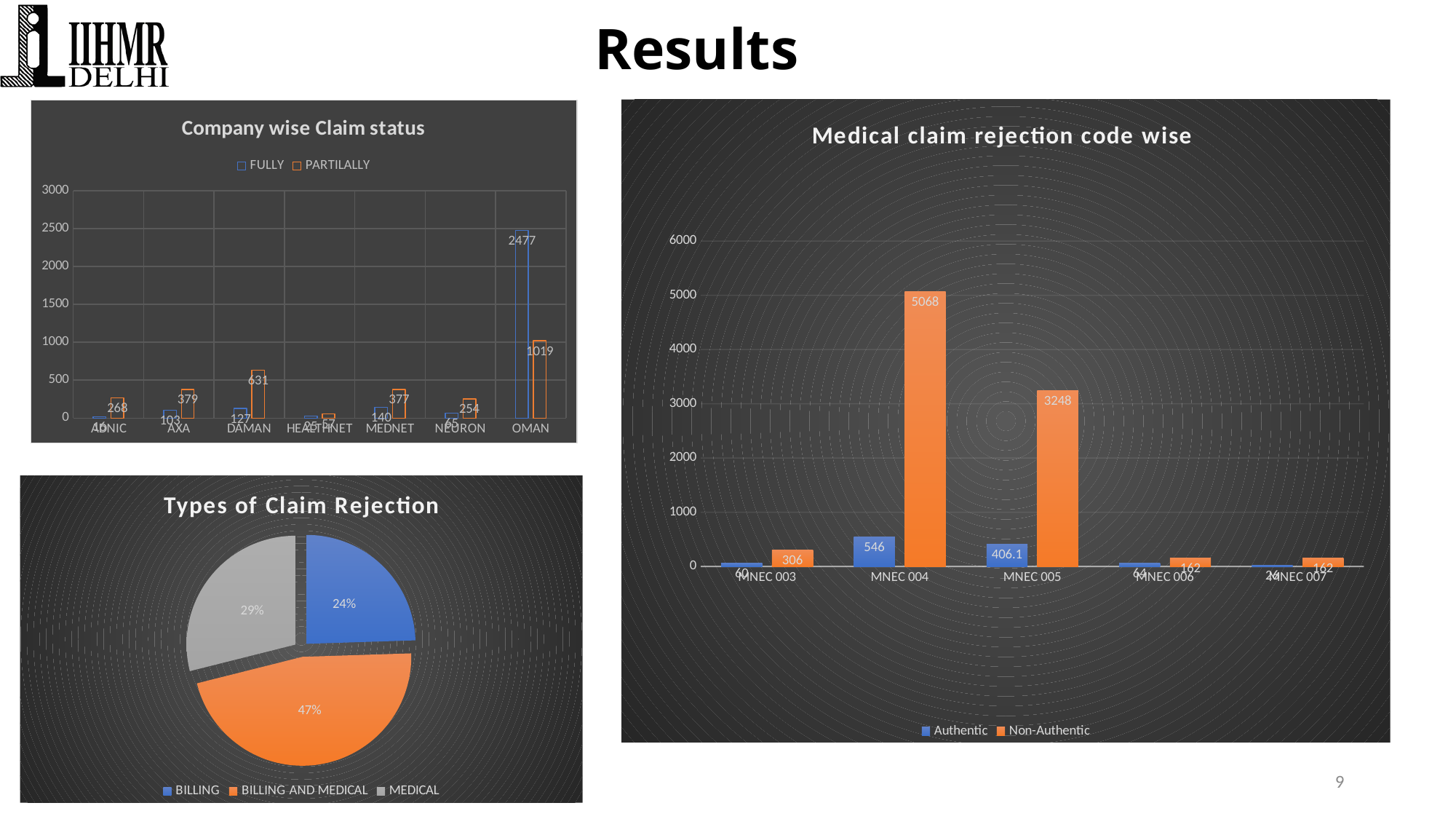
In the 'Company wise Claim status' chart, which company has the highest PARTIALLY value? OMAN In the 'Types of Claim Rejection' pie chart, what share does BILLING AND MEDICAL have? 47% In the 'Company wise Claim status' chart, what is the FULLY value for OMAN? 2477 In the 'Medical claim rejection code wise' chart, which is larger: the Non-Authentic value for MNEC 004 or for MNEC 005? MNEC 004 In the 'Medical claim rejection code wise' chart, what is the Authentic value for MNEC 005? 406.1 In the 'Medical claim rejection code wise' chart, what is the Non-Authentic value for MNEC 004? 5068 In the 'Types of Claim Rejection' pie chart, which category has the smallest slice? BILLING In the 'Company wise Claim status' chart, how many companies are shown on the x axis? 7 In the 'Company wise Claim status' chart, what is the difference between the FULLY and PARTIALLY values for OMAN? 1458 In the 'Company wise Claim status' chart, what is the PARTIALLY value for DAMAN? 631 What kind of chart is 'Types of Claim Rejection'? Pie chart How many series does the legend of the 'Medical claim rejection code wise' chart list? 2